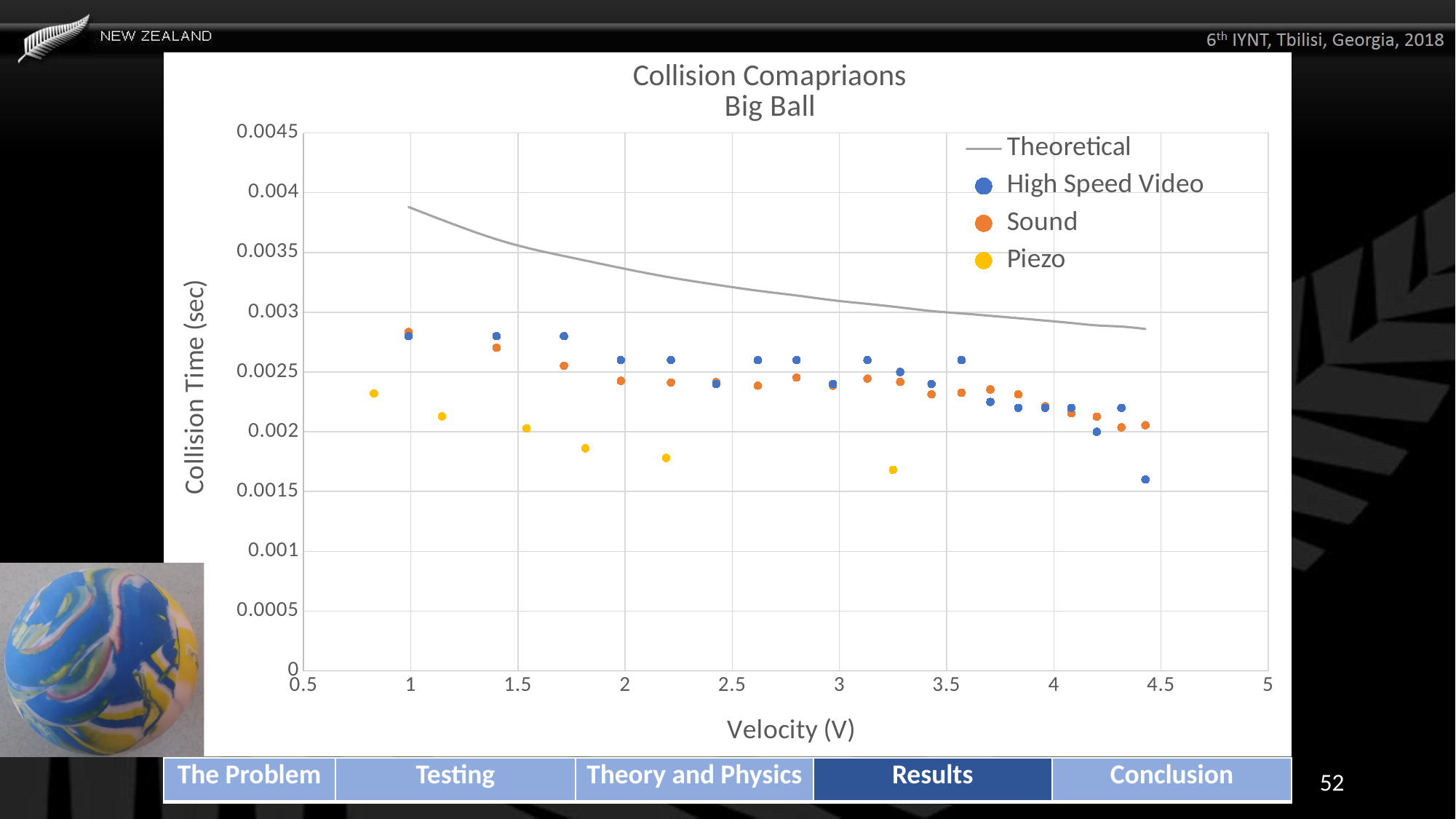
How many Piezo data points are plotted? 6 What is the label of the vertical axis? Collision Time (sec) What is the title of the chart? Collision Comapriaons Big Ball How many series does the legend list? 4 What kind of chart is shown on the slide? Scatter chart Which series lies highest on the chart across the velocity range? Theoretical Does the Theoretical line rise or fall as velocity increases? Fall Which series has the lowest collision time values overall? Piezo What is the maximum value shown on the vertical axis? 0.0045 Is the lowest High Speed Video point, near velocity 4.45, greater or less than 0.002? less Is the Theoretical value at velocity 1 greater or less than 0.0035? greater Is the Piezo value near velocity 3.25 greater or less than 0.002? less